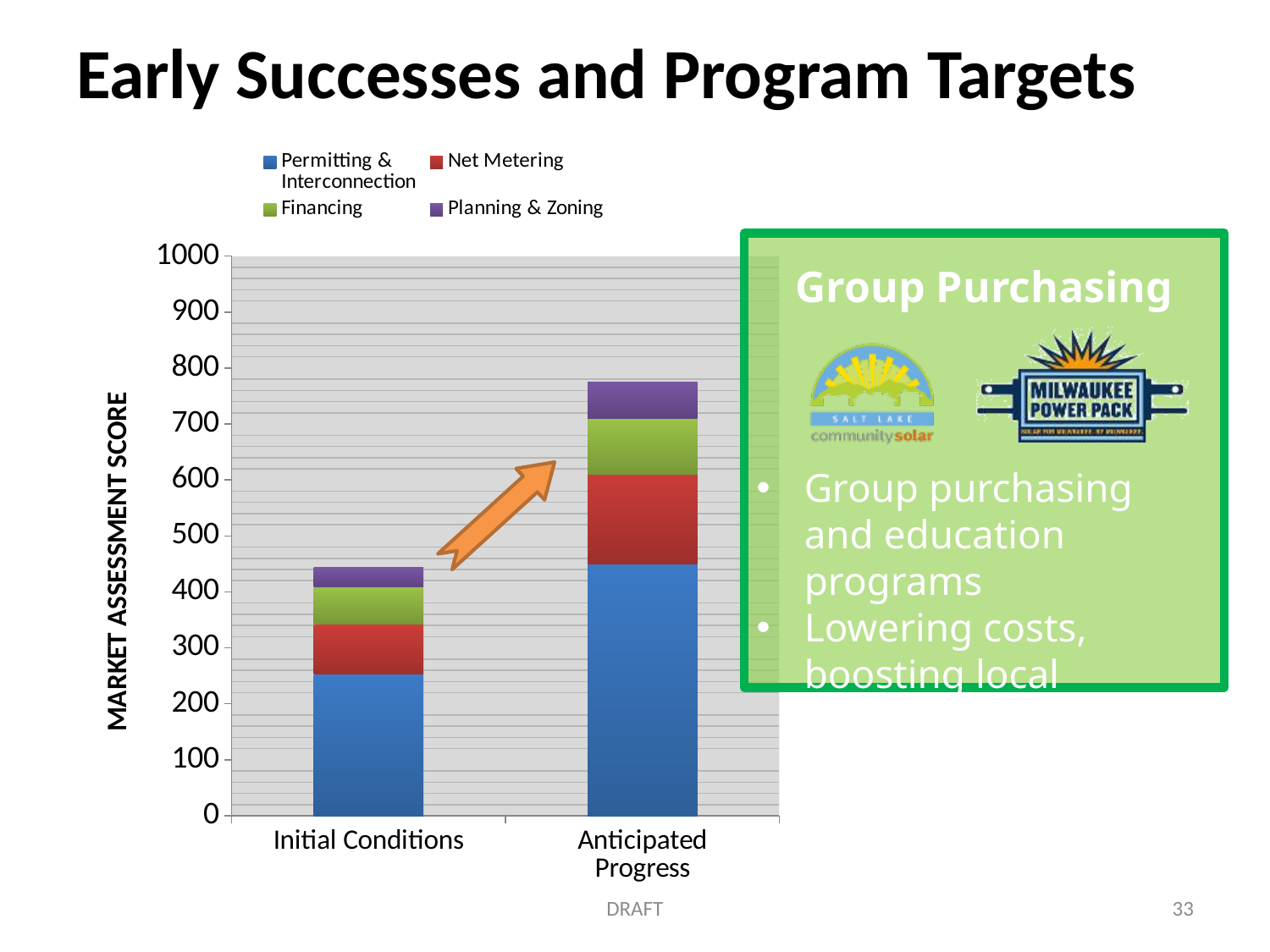
How many series does the chart's legend list? 4 Is the Permitting & Interconnection value for Initial Conditions greater or less than 300? less Which series is shown in green in the chart's legend? Financing Which category has the lowest total market assessment score? Initial Conditions How many categories are shown on the x axis of the chart? 2 What kind of chart is shown on the slide? Stacked bar chart What is the title of the chart's vertical axis? MARKET ASSESSMENT SCORE Which category has the taller stacked bar, Initial Conditions or Anticipated Progress? Anticipated Progress Is the Permitting & Interconnection value for Anticipated Progress greater or less than 400? greater Is the total stacked value for Anticipated Progress greater or less than 700? greater Do the total stacked values rise or fall from Initial Conditions to Anticipated Progress? Rise